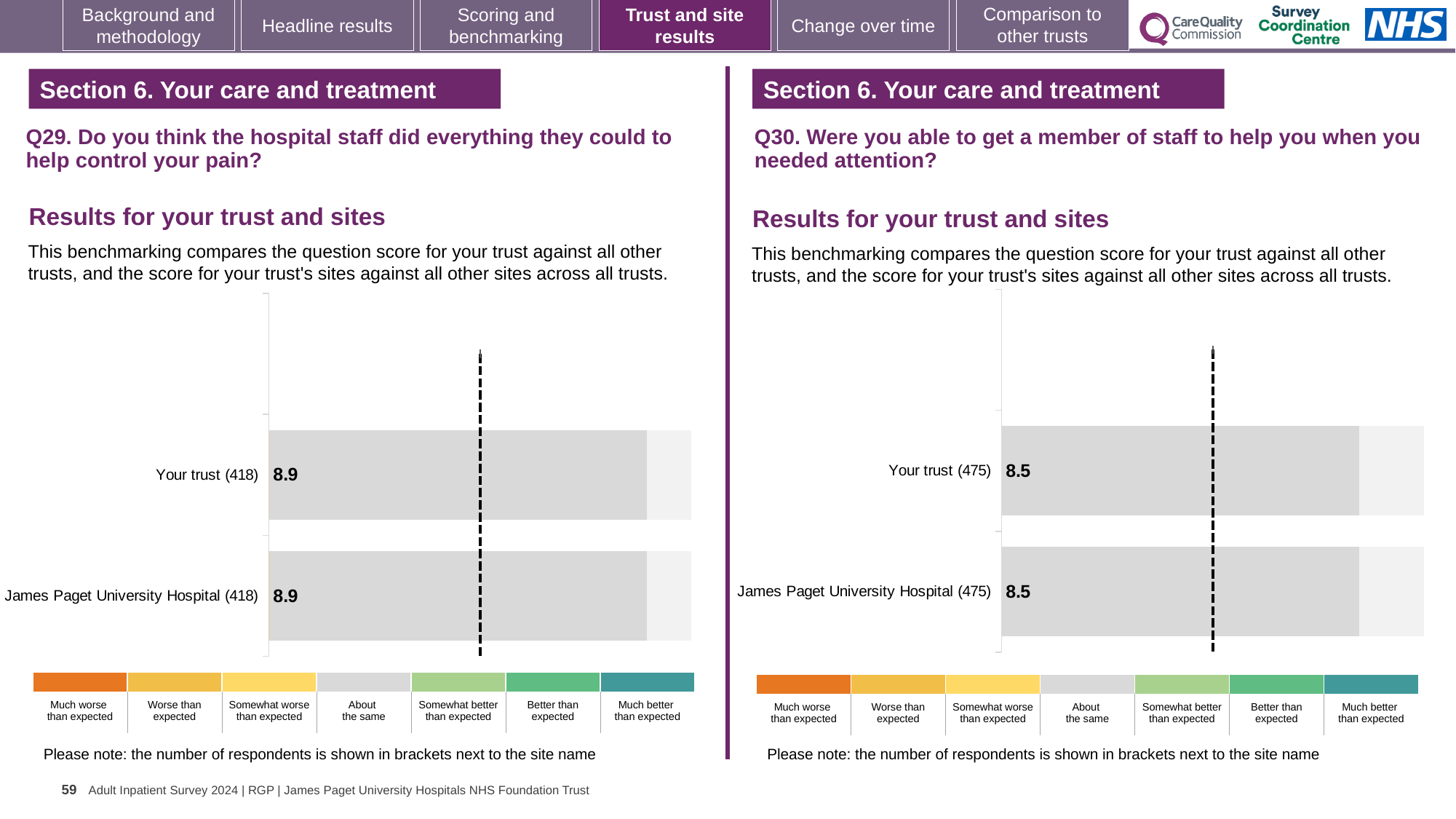
On the Q30 chart (right), how many respondents are shown in brackets next to James Paget University Hospital? 475 On the Q29 chart (left), what is the score for James Paget University Hospital? 8.9 How many bars are plotted on the Q30 chart (right)? 2 How many bars are plotted on the Q29 chart (left)? 2 On the Q29 chart (left), how many respondents are shown in brackets next to Your trust? 418 On the Q30 chart (right), what is the difference between the score for Your trust and the score for James Paget University Hospital? 0 On the Q29 chart (left), what is the score for Your trust? 8.9 On the Q30 chart (right), what is the score for James Paget University Hospital? 8.5 What kind of chart is used on the Q29 chart (left)? Bar chart On the Q29 chart (left), what is the difference between the score for Your trust and the score for James Paget University Hospital? 0 On the Q30 chart (right), what is the score for Your trust? 8.5 Is the score for Your trust on the Q29 chart (left) larger or smaller than the score for Your trust on the Q30 chart (right)? Larger